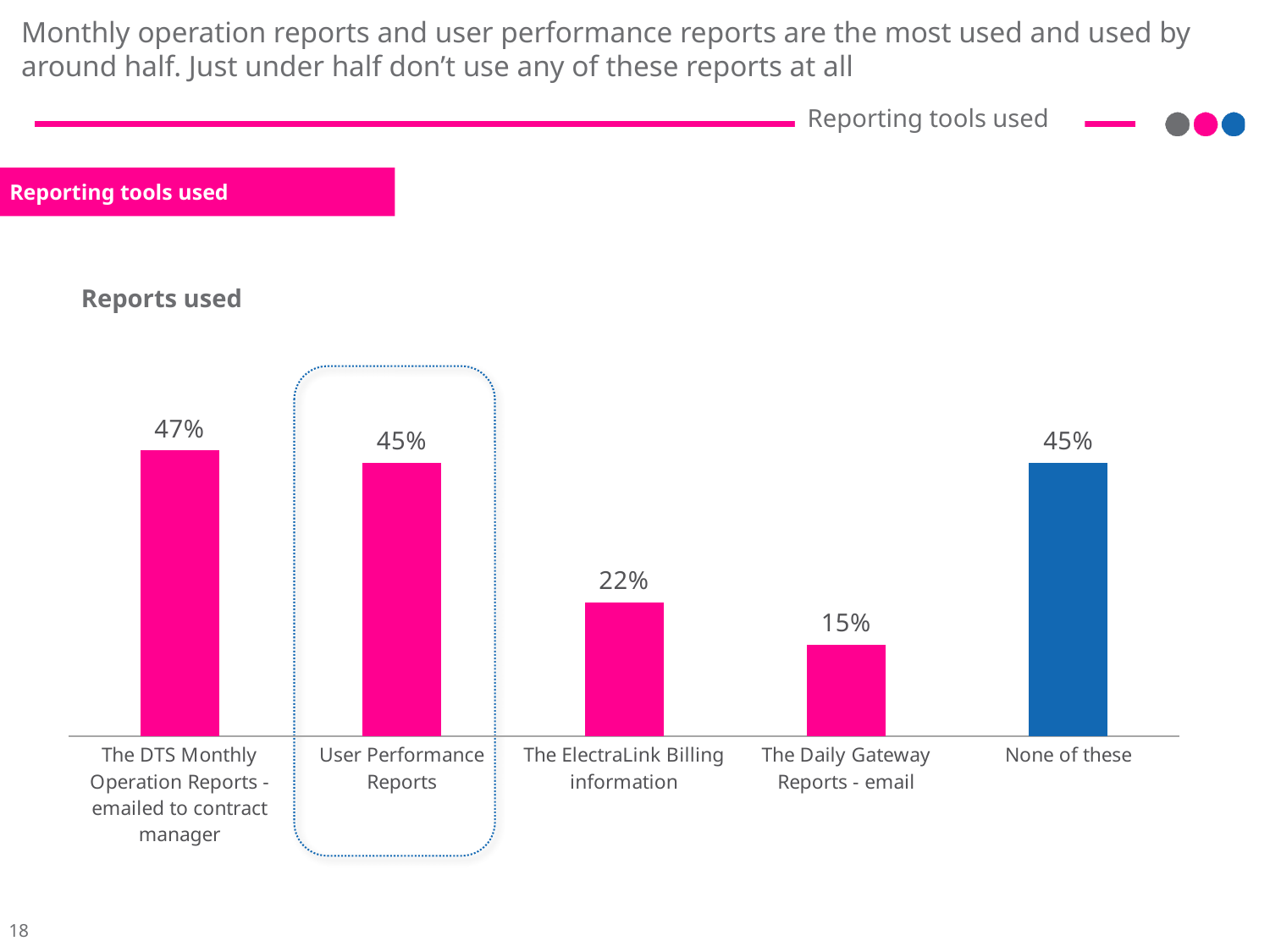
What percentage of respondents use The DTS Monthly Operation Reports - emailed to contract manager? 47% How many categories are shown in the Reports used chart? 5 What is the difference between the values for The ElectraLink Billing information and The Daily Gateway Reports - email? 7% What is the value for The Daily Gateway Reports - email? 15% Which category has the highest value in the Reports used chart? The DTS Monthly Operation Reports - emailed to contract manager Which is larger: the value for The ElectraLink Billing information or the value for None of these? None of these What is the value shown for User Performance Reports? 45% What percentage is shown for The ElectraLink Billing information? 22% What type of chart is shown on the slide? Bar chart Which category has the lowest value in the Reports used chart? The Daily Gateway Reports - email What percentage of respondents selected None of these? 45% Which bar in the chart is coloured blue rather than pink? None of these